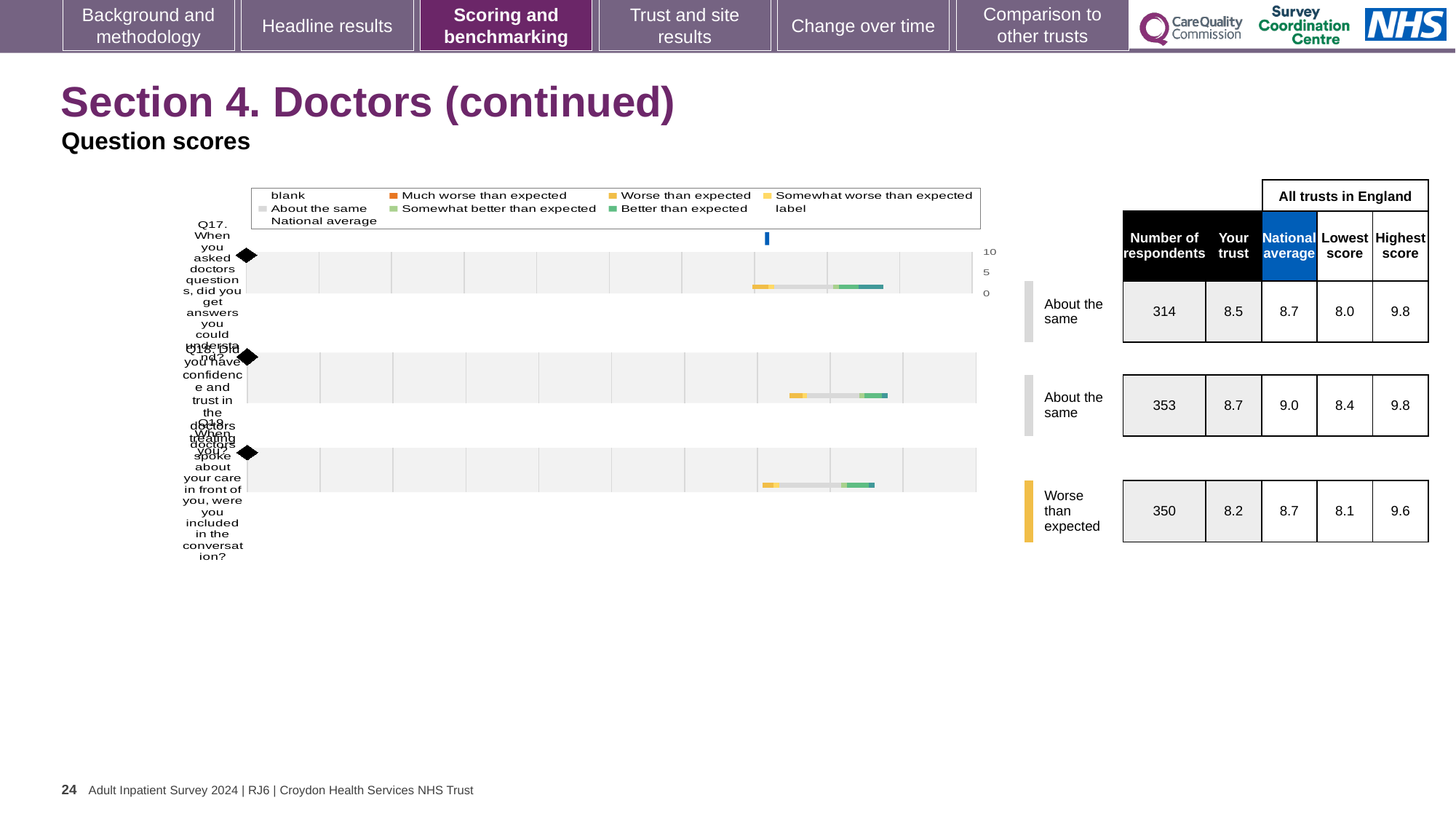
What is the highest score across all trusts in England for Q19? 9.6 How many respondents answered Q19 (When doctors spoke about your care in front of you, were you included in the conversation?)? 350 How many questions (categories) are plotted in the chart? 3 What kind of chart is shown on the slide? bar chart Is the 'Your trust' score larger for Q17 or Q19? Q17 What is the 'Your trust' score for Q17 (When you asked doctors questions, did you get answers you could understand?)? 8.5 Which question has the highest number of respondents? Q18 What is the lowest score across all trusts in England for Q17? 8.0 What benchmark category is shown for Q19? Worse than expected What is the difference between the national average and the 'Your trust' score for Q18? 0.3 What is the national average score for Q18 (Did you have confidence and trust in the doctors treating you?)? 9.0 Which question has the lowest 'Your trust' score? Q19